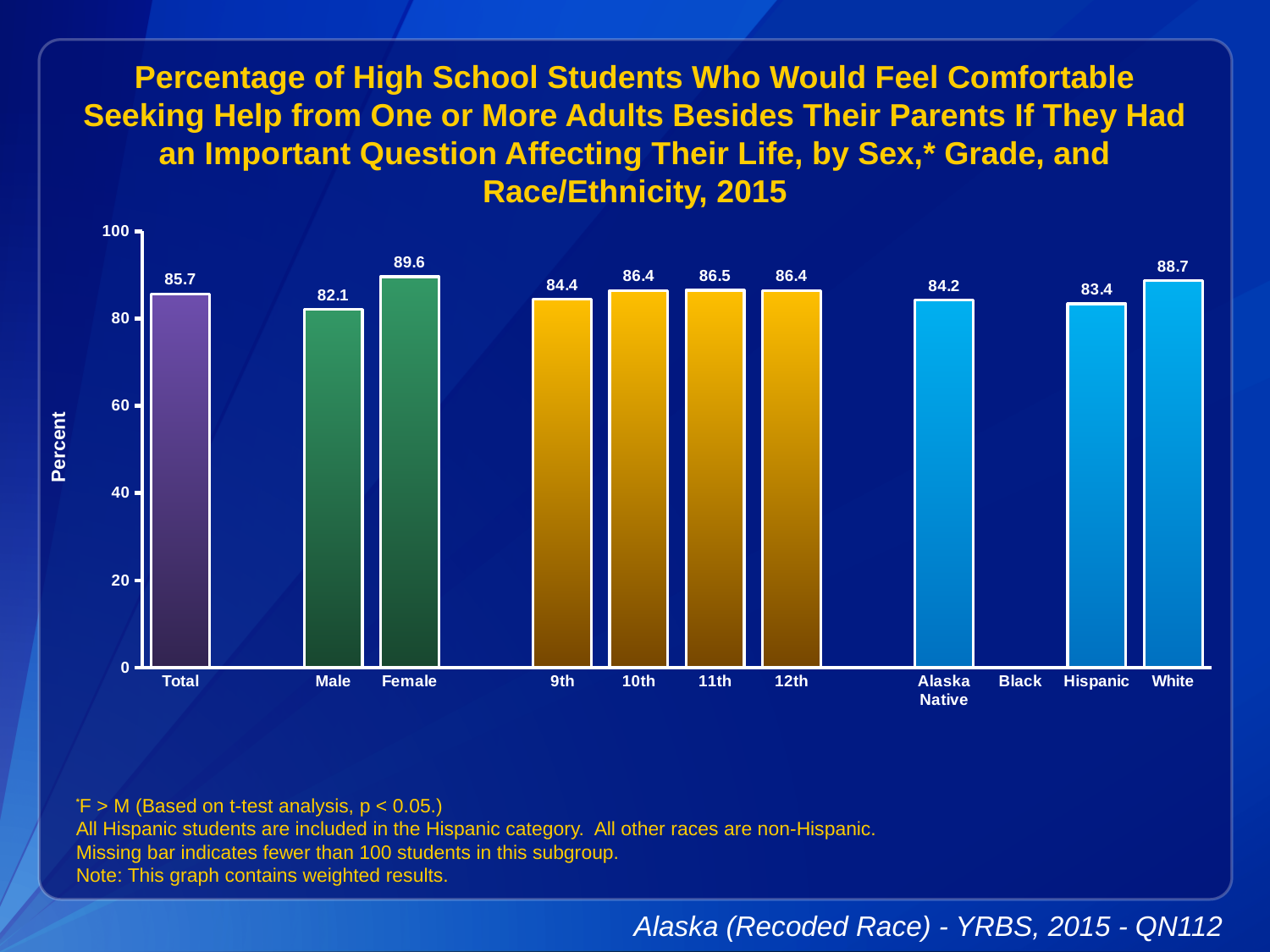
What is the value for Female? 89.6 How many categories have a bar plotted? 11 What kind of chart is shown? Bar chart What is the value for Total? 85.7 What is the value for Alaska Native? 84.2 Which category with a bar has the lowest value? Male Which category has no bar shown? Black What is the difference between the Female and Male values? 7.5 What is the value for Male? 82.1 Which is larger, the value for White or the value for Hispanic? White Which category has the highest value? Female Is the value for 9th greater or less than 80? greater